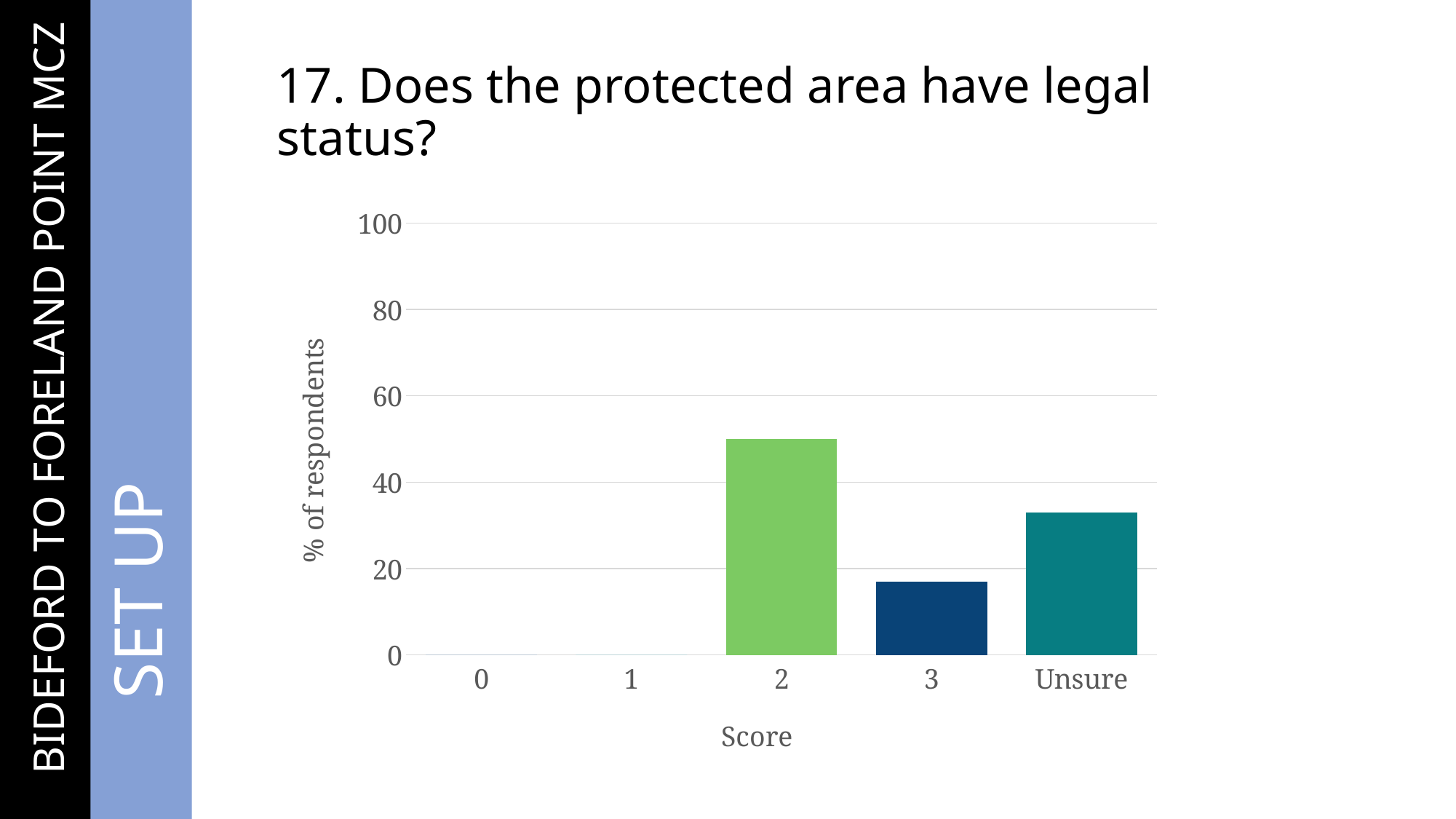
What is the label of the y axis? % of respondents Which has a higher percentage of respondents, score 2 or Unsure? 2 Is the value for score 2 greater or less than 60? less Is the value for Unsure greater or less than 20? greater What is the label of the x axis? Score How many score categories are shown on the x axis? 5 Which has a higher percentage of respondents, score 3 or Unsure? Unsure Is the value for score 3 greater or less than 20? less Which score category has the highest percentage of respondents? 2 What kind of chart is shown on the slide? bar chart